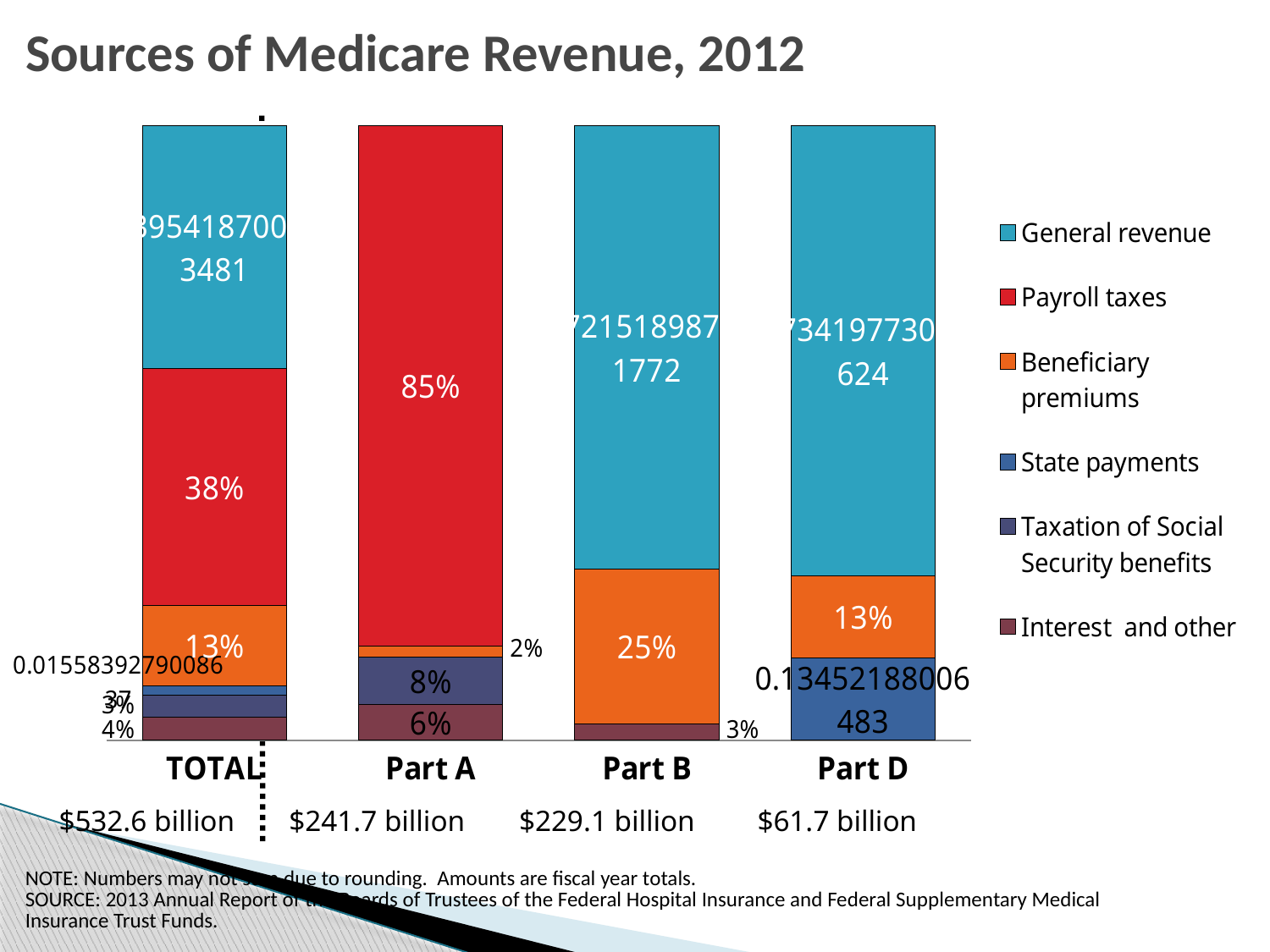
What is the title of the chart? Sources of Medicare Revenue, 2012 What share of Part B revenue comes from beneficiary premiums? 25% What share of Part D revenue comes from beneficiary premiums? 13% What share of TOTAL Medicare revenue comes from payroll taxes? 38% What is the total revenue amount shown for Part B? $229.1 billion What is the difference between the beneficiary premiums share for Part B and for Part D? 12% What share of Part A revenue comes from taxation of Social Security benefits? 8% How many bars (categories) are plotted on the chart? 4 How many series does the legend list? 6 Which bar has the larger payroll taxes share, TOTAL or Part A? Part A What kind of chart is shown on the slide? Stacked bar chart What share of Part A revenue comes from payroll taxes? 85%